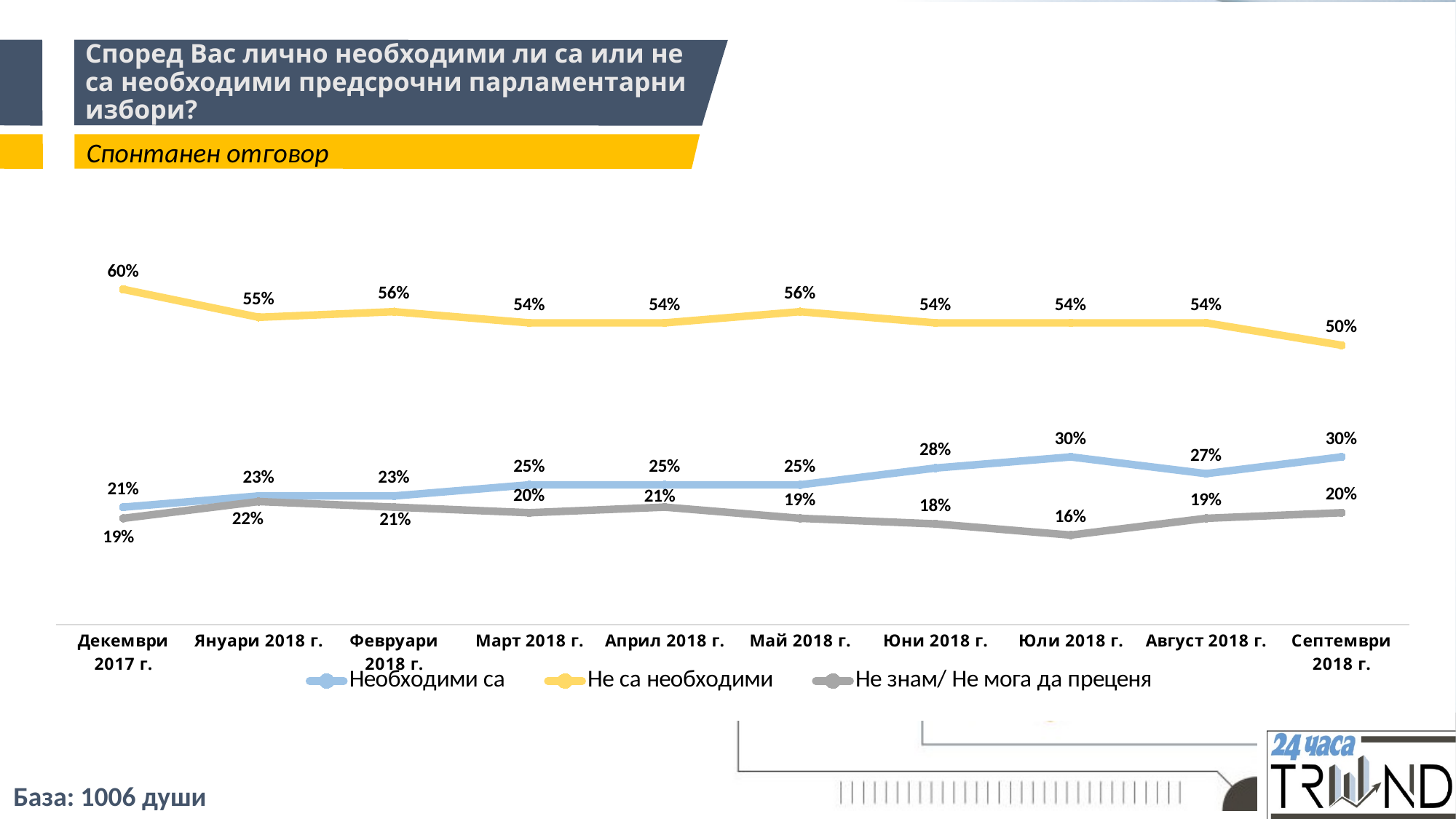
What is the value for "Необходими са" in Септември 2018 г.? 30% What is the value for "Не са необходими" in Декември 2017 г.? 60% How many time points are plotted along the x axis? 10 In which month is the value for "Не знам/ Не мога да преценя" lowest? Юли 2018 г. What colour is the line for "Не са необходими"? yellow What is the difference between "Не са необходими" and "Необходими са" in Септември 2018 г.? 20% What type of chart is shown on the slide? line chart In which month is the value for "Не са необходими" lowest? Септември 2018 г. Which is larger in Януари 2018 г.: "Необходими са" or "Не знам/ Не мога да преценя"? Необходими са What is the value for "Не знам/ Не мога да преценя" in Юли 2018 г.? 16% How many series does the legend list? 3 Does the value for "Не са необходими" generally rise or fall from Декември 2017 г. to Септември 2018 г.? fall